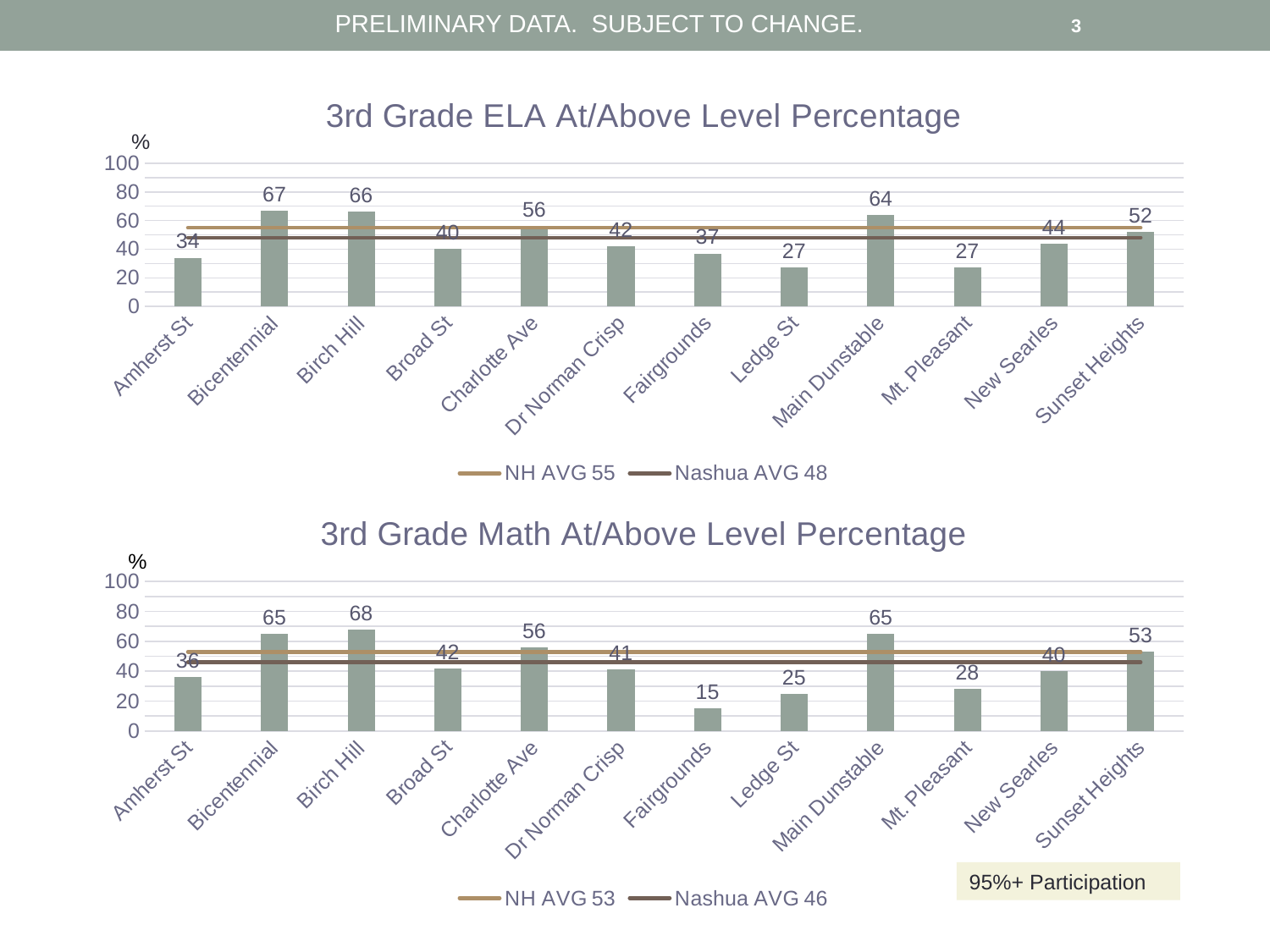
How many schools are shown on the x axis of the 3rd Grade Math At/Above Level Percentage chart? 12 What is the NH AVG value shown in the legend of the 3rd Grade Math At/Above Level Percentage chart? 53 In the 3rd Grade ELA At/Above Level Percentage chart, what is the value for Charlotte Ave? 56 In the 3rd Grade ELA At/Above Level Percentage chart, what is the value for Main Dunstable? 64 In the 3rd Grade ELA At/Above Level Percentage chart, which is larger, New Searles or Fairgrounds? New Searles In the 3rd Grade Math At/Above Level Percentage chart, what is the difference between Main Dunstable and Ledge St? 40 In the 3rd Grade Math At/Above Level Percentage chart, what is the value for Sunset Heights? 53 What kind of chart is the 3rd Grade ELA At/Above Level Percentage chart? Bar chart In the 3rd Grade ELA At/Above Level Percentage chart, what is the difference between Bicentennial and Amherst St? 33 In the 3rd Grade Math At/Above Level Percentage chart, what is the value for Fairgrounds? 15 In the 3rd Grade Math At/Above Level Percentage chart, which school has the highest value? Birch Hill In the 3rd Grade Math At/Above Level Percentage chart, which school has the lowest value? Fairgrounds